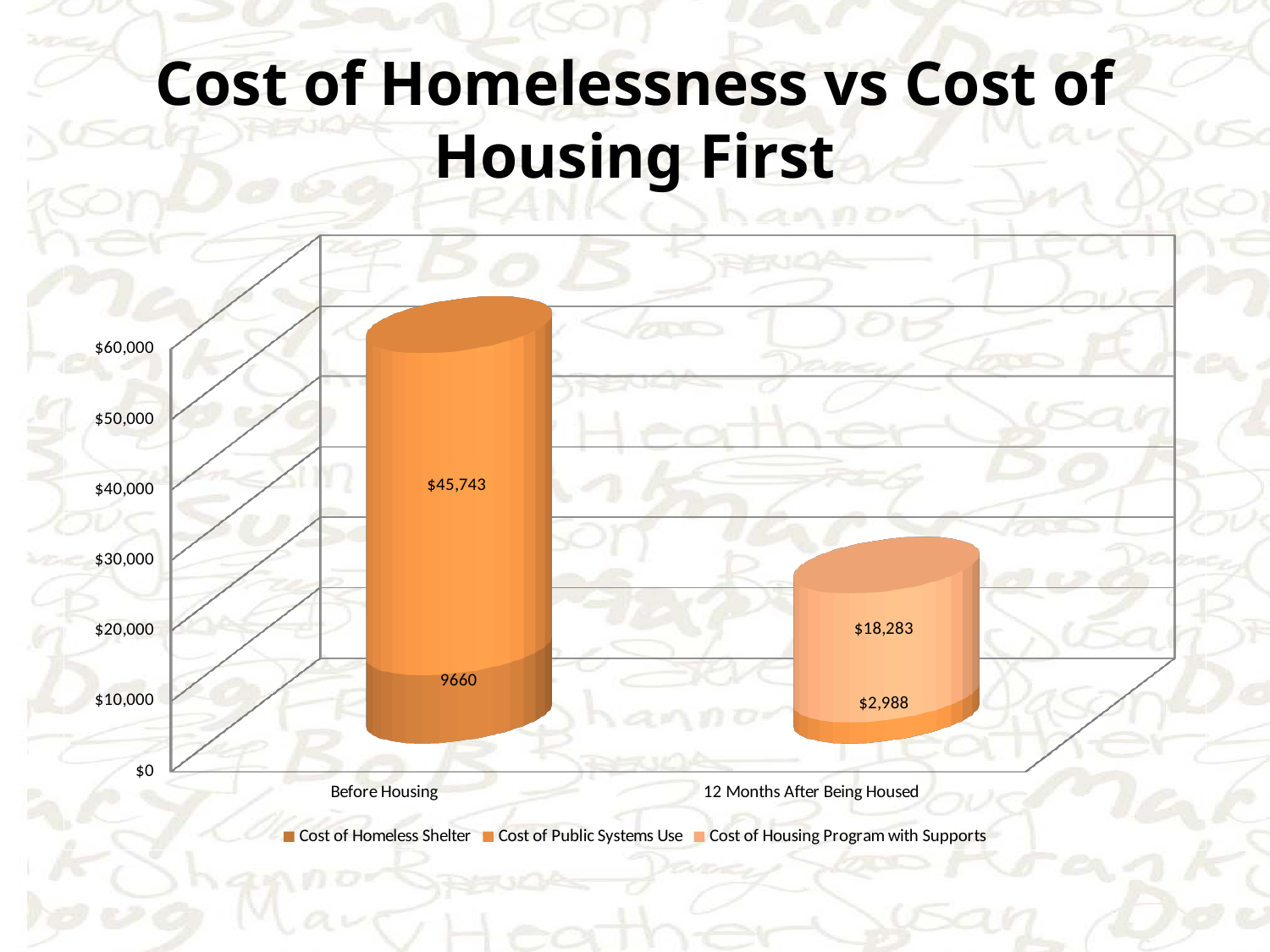
What is the Cost of Public Systems Use for Before Housing? $45,743 What is the total of the stacked bar for Before Housing? $55,403 What is the difference between the Cost of Public Systems Use Before Housing and 12 Months After Being Housed? $42,755 Which category has the taller stacked bar, Before Housing or 12 Months After Being Housed? Before Housing What is the title of the chart? Cost of Homelessness vs Cost of Housing First What is the Cost of Homeless Shelter for Before Housing? 9660 What is the Cost of Housing Program with Supports for 12 Months After Being Housed? $18,283 What is the total of the stacked bar for 12 Months After Being Housed? $21,271 How many series does the legend list? 3 Is the total for 12 Months After Being Housed greater or less than $30,000? less How many categories are shown on the x axis? 2 What is the Cost of Public Systems Use for 12 Months After Being Housed? $2,988